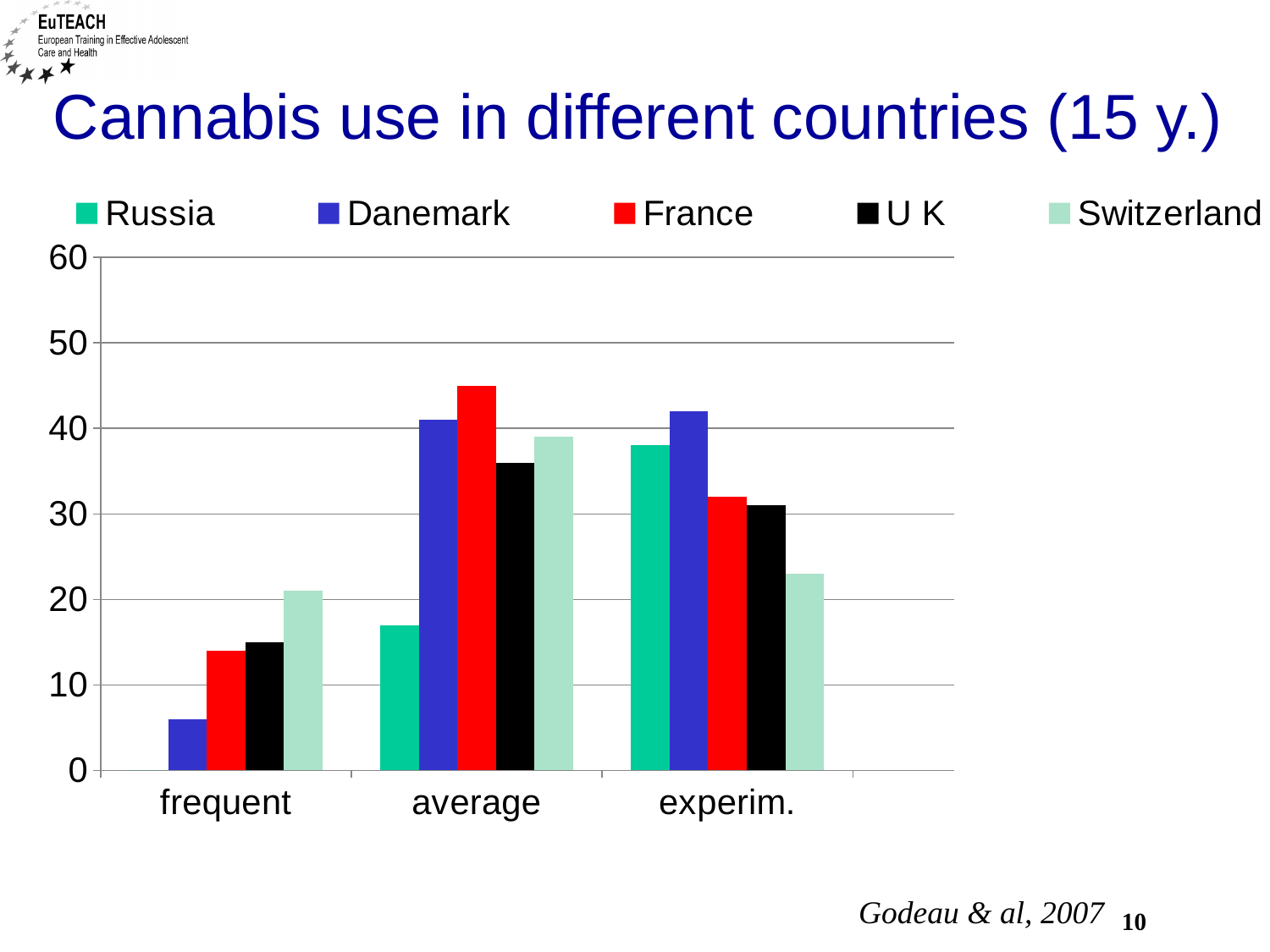
Is the value for France in the 'average' category greater or less than 40? greater What kind of chart is shown on the slide? bar chart Is the value for Switzerland in the 'experim.' category greater or less than 30? less Which country has the highest value in the 'frequent' category? Switzerland Which country has the lowest value in the 'average' category? Russia How many series does the legend list? 5 Which country has the highest value in the 'average' category? France How many categories are shown on the x axis? 3 What is the title of the chart? Cannabis use in different countries (15 y.) In the 'average' category, which is larger: France or U K? France Is the value for Danemark in the 'frequent' category greater or less than 10? less Which country has the lowest value in the 'experim.' category? Switzerland